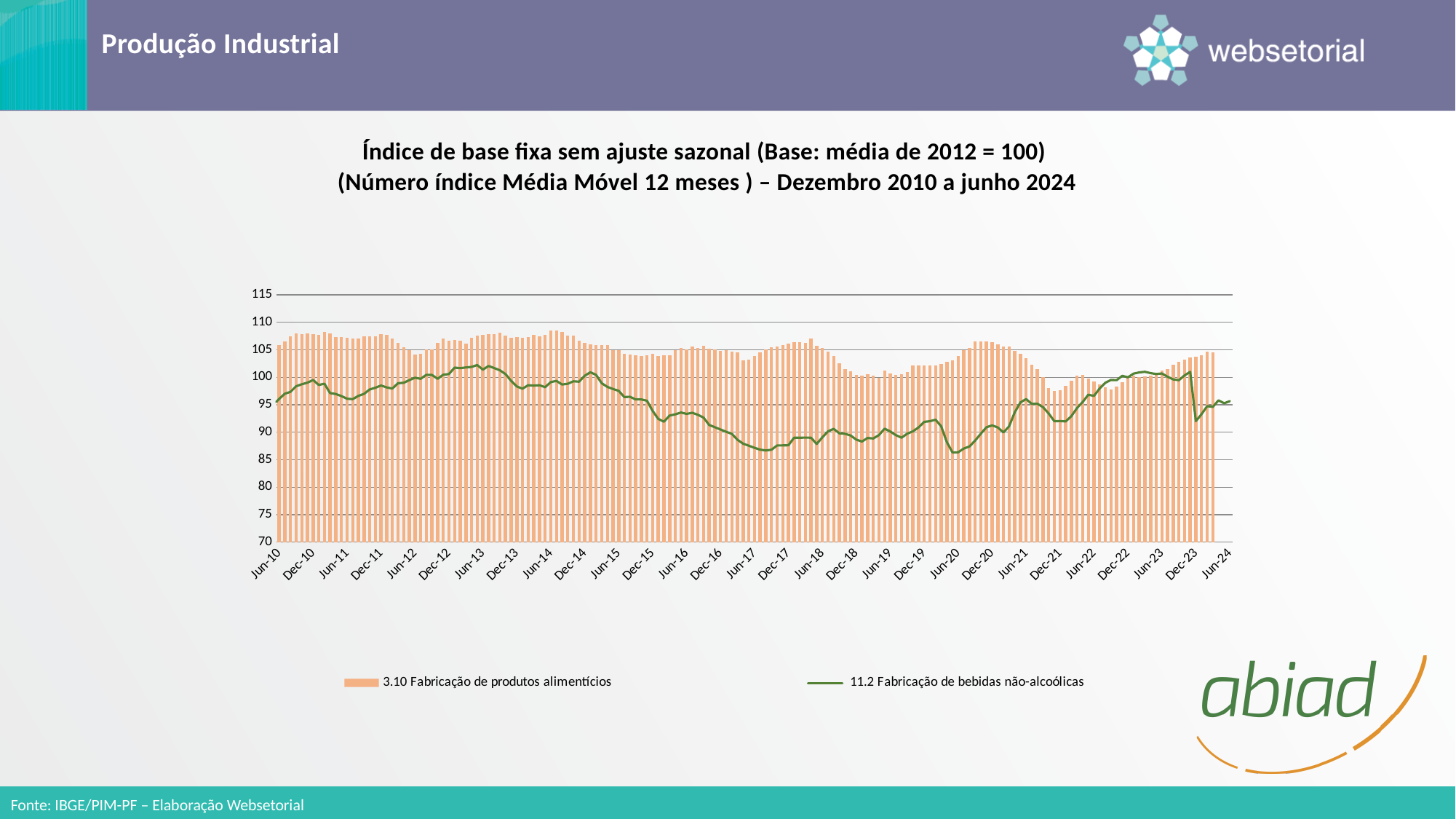
What is the highest value shown on the vertical axis? 115 Does the line series (11.2 Fabricação de bebidas não-alcoólicas) rise or fall between Jun-19 and Jun-20? fall Is the value of the bar series (3.10 Fabricação de produtos alimentícios) at Jun-17 greater or less than 100? greater What kind of chart is this? Combined bar and line chart Is the value of the line series (11.2 Fabricação de bebidas não-alcoólicas) at Jun-13 greater or less than 100? greater Which series is drawn as a line? 11.2 Fabricação de bebidas não-alcoólicas Is the value of the line series (11.2 Fabricação de bebidas não-alcoólicas) at Jun-20 greater or less than 90? less Does the line series (11.2 Fabricação de bebidas não-alcoólicas) rise or fall between Jun-20 and Jun-21? rise At Jun-20, which series has the higher value: 3.10 Fabricação de produtos alimentícios or 11.2 Fabricação de bebidas não-alcoólicas? 3.10 Fabricação de produtos alimentícios Which series is drawn as bars? 3.10 Fabricação de produtos alimentícios How many series does the legend list? 2